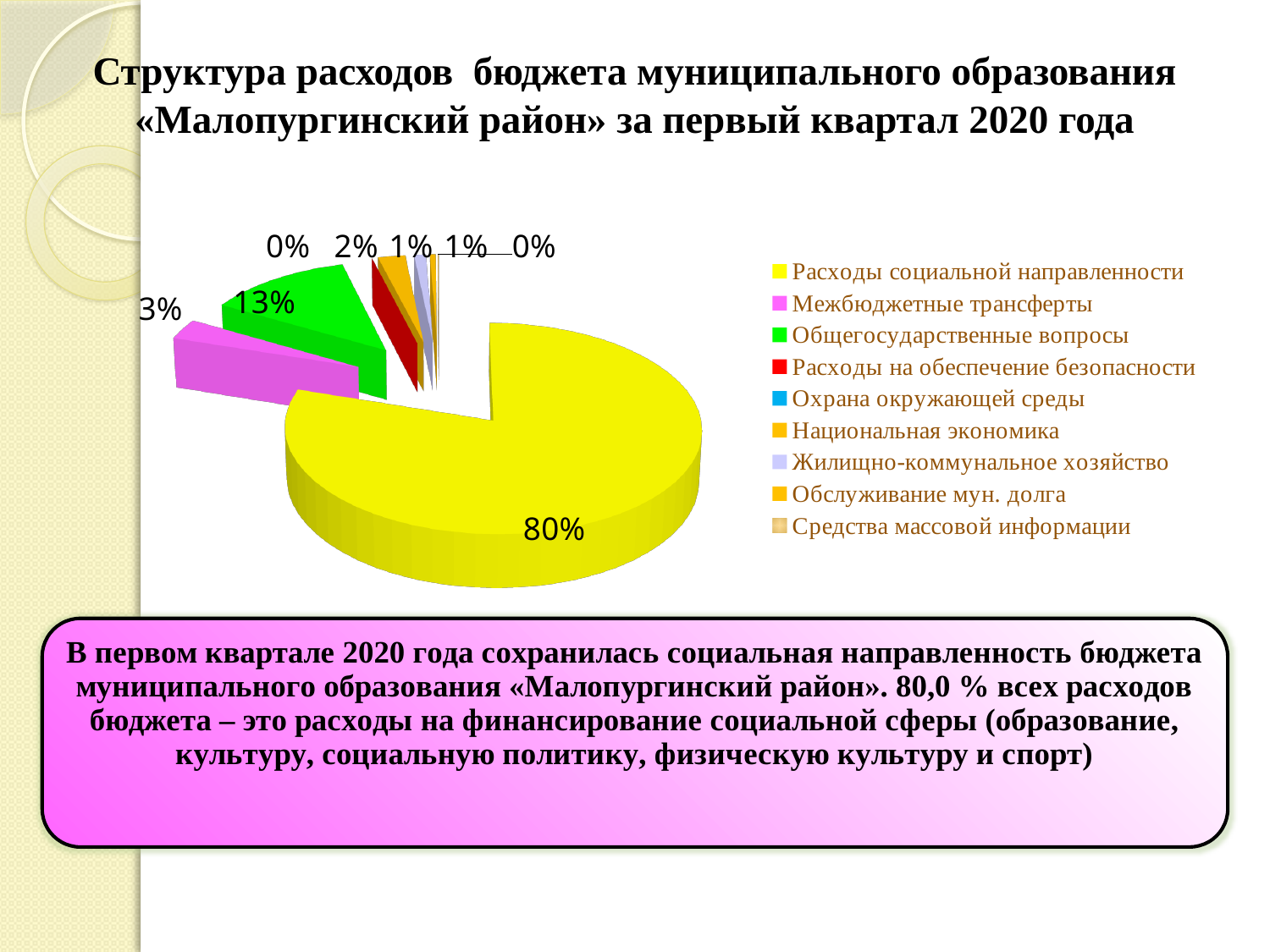
What share of the pie does «Расходы социальной направленности» account for? 80% How many categories does the legend list? 9 What is the value shown for «Общегосударственные вопросы»? 13% Which category has the largest slice of the pie? Расходы социальной направленности What kind of chart is shown on the slide? Pie chart What is the value shown for «Межбюджетные трансферты»? 3% Which is larger: «Общегосударственные вопросы» or «Межбюджетные трансферты»? Общегосударственные вопросы What colour is the slice for «Расходы социальной направленности»? Yellow What colour is the slice for «Общегосударственные вопросы»? Green What is the difference in percentage points between «Общегосударственные вопросы» and «Межбюджетные трансферты»? 10 percentage points What is the difference in percentage points between «Расходы социальной направленности» and «Общегосударственные вопросы»? 67 percentage points